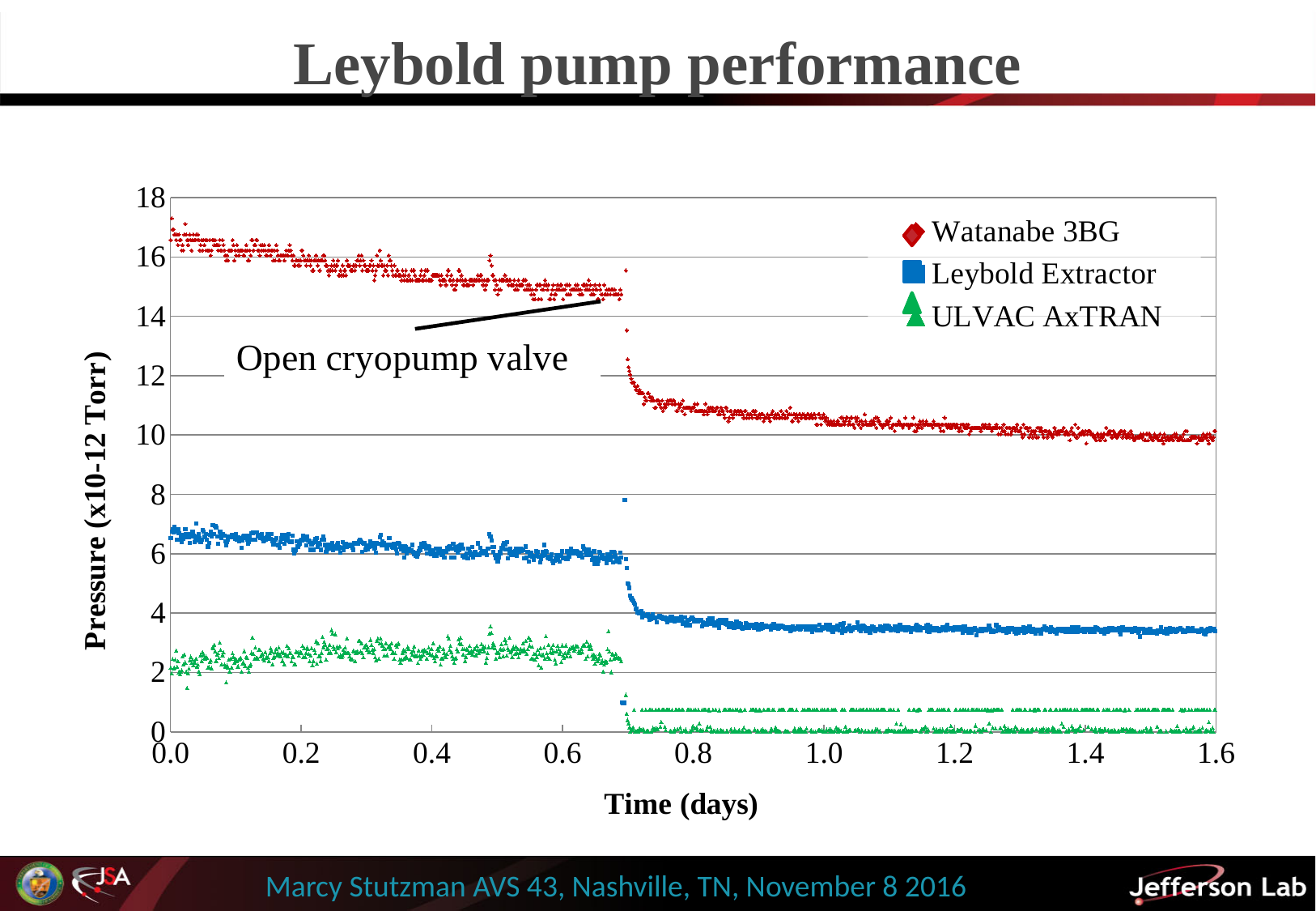
What kind of chart is shown on the slide? scatter chart Is the pressure for Watanabe 3BG at time 0.0 days greater or less than 16? greater Which series shows the lowest pressure across the whole time range? ULVAC AxTRAN Is the pressure for Leybold Extractor at time 1.6 days greater or less than 4? less Is the pressure for ULVAC AxTRAN at time 0.4 days greater or less than 2? greater Does the pressure for Watanabe 3BG rise or fall as time increases? fall How many series does the legend list? 3 Which series are listed in the legend? Watanabe 3BG, Leybold Extractor, ULVAC AxTRAN What text annotation is written on the chart near the drop in pressure? Open cryopump valve Which series shows the highest pressure across the whole time range? Watanabe 3BG At time 1.0 days, which is larger: the pressure for Leybold Extractor or for ULVAC AxTRAN? Leybold Extractor